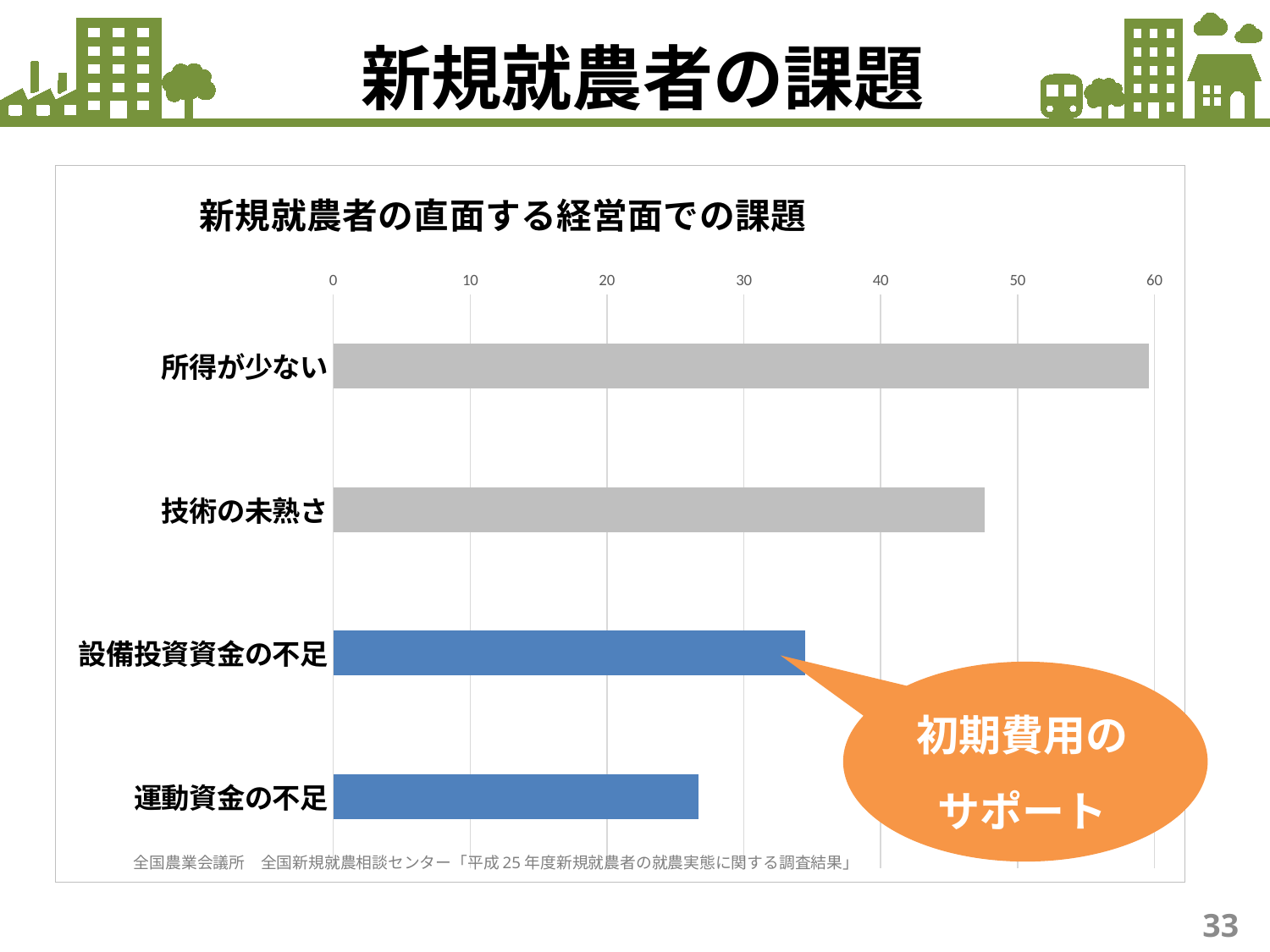
Which two categories are drawn with blue bars? 設備投資資金の不足 and 運動資金の不足 Which category has the lowest value in the chart? 運動資金の不足 How many categories are plotted in the chart? 4 What is the title of the chart? 新規就農者の直面する経営面での課題 Is the value for 技術の未熟さ greater or less than 40? greater What kind of chart is shown on the slide? bar chart Is the value for 所得が少ない greater or less than 50? greater Is the value for 運動資金の不足 greater or less than 30? less Which is larger, the value for 設備投資資金の不足 or the value for 運動資金の不足? 設備投資資金の不足 Which is larger, the value for 技術の未熟さ or the value for 設備投資資金の不足? 技術の未熟さ Which category has the highest value in the chart? 所得が少ない